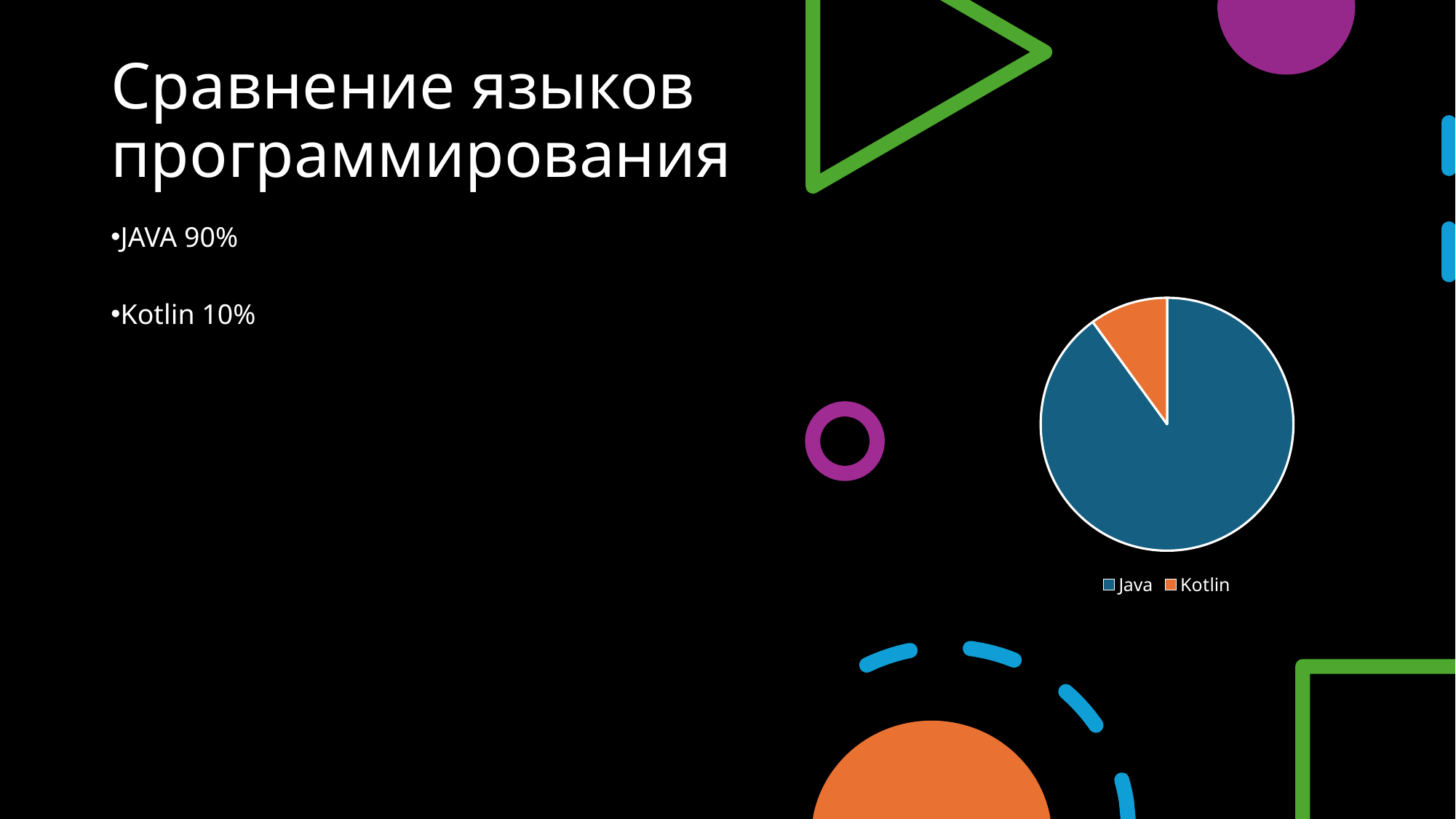
What share of the pie does Kotlin take, according to the slide? 10% Which slice of the pie chart is the smallest? Kotlin How many entries does the legend of the pie chart list? 2 Which is larger in the pie chart, Java or Kotlin? Java By how many percentage points does Java's share exceed Kotlin's share, according to the values on the slide? 80 What share of the pie does Java take, according to the slide? 90% What colour is the Java slice in the pie chart? blue What kind of chart is shown on the slide? pie chart Is Kotlin's share of the pie greater or less than 50%? less What colour is the Kotlin slice in the pie chart? orange Which slice of the pie chart is the largest? Java How many slices does the pie chart have? 2